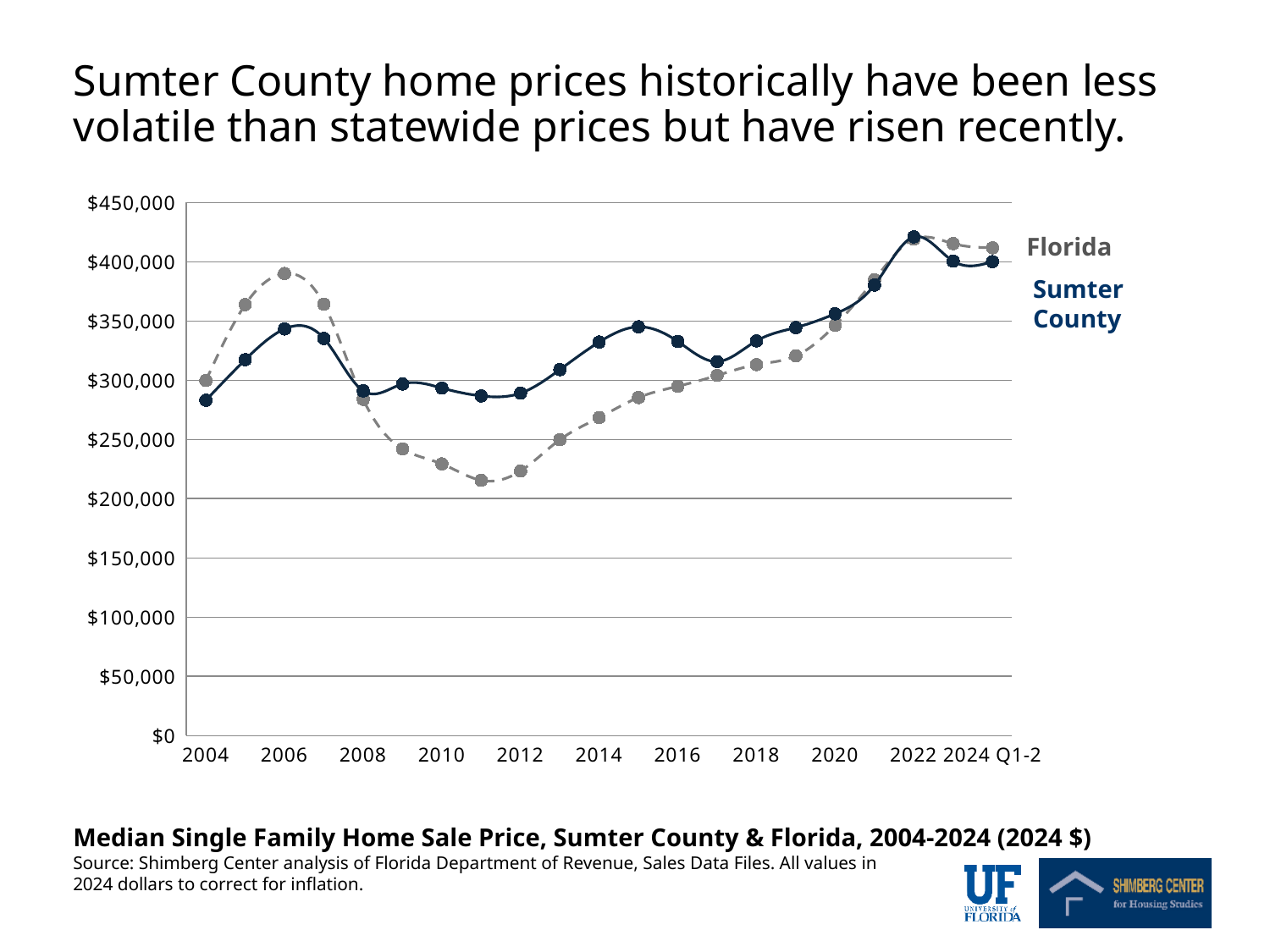
Is the Florida value for 2006 greater or less than $350,000? greater Is the Sumter County value for 2006 greater or less than $350,000? less Is the Sumter County value for 2022 greater or less than $400,000? greater In 2006, which series has the higher value, Florida or Sumter County? Florida In 2011, which series has the higher value, Florida or Sumter County? Sumter County What is the title of the chart? Median Single Family Home Sale Price, Sumter County & Florida, 2004-2024 (2024 $) How many series does the chart show? 2 What kind of chart is shown on the slide? Line chart Does the Florida series rise or fall between 2006 and 2011? Fall In which year does the Florida series reach its lowest value? 2011 Which two series are plotted on the chart? Florida and Sumter County